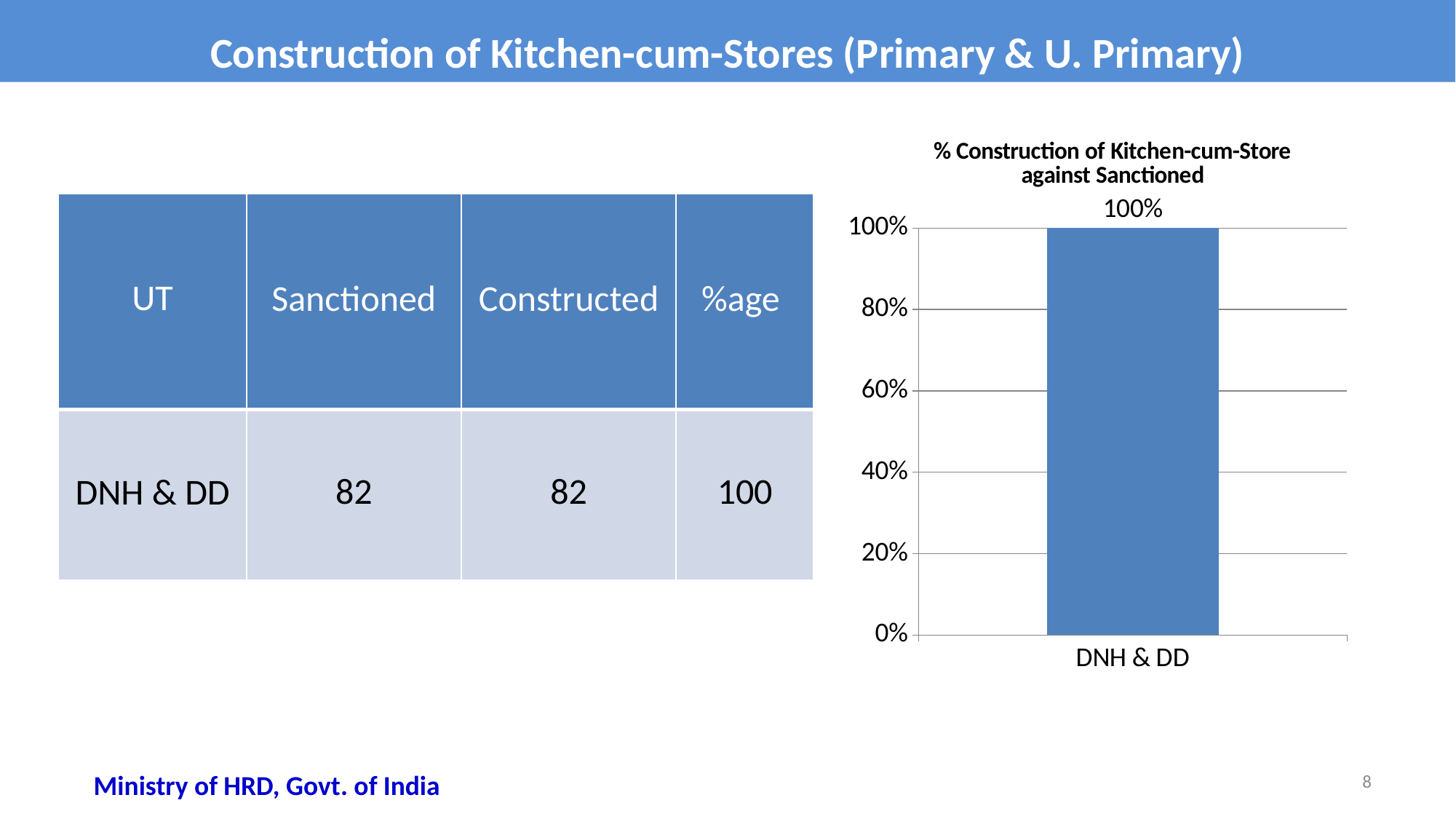
What is the value for DNH & DD in the chart? 100% What kind of chart is shown on the slide? bar chart What is the title of the chart? % Construction of Kitchen-cum-Store against Sanctioned Is the value for DNH & DD greater or less than 80%? greater What is the highest value shown on the chart's y axis? 100% How many categories are plotted on the x axis of the chart? 1 Which category has the highest value in the chart? DNH & DD